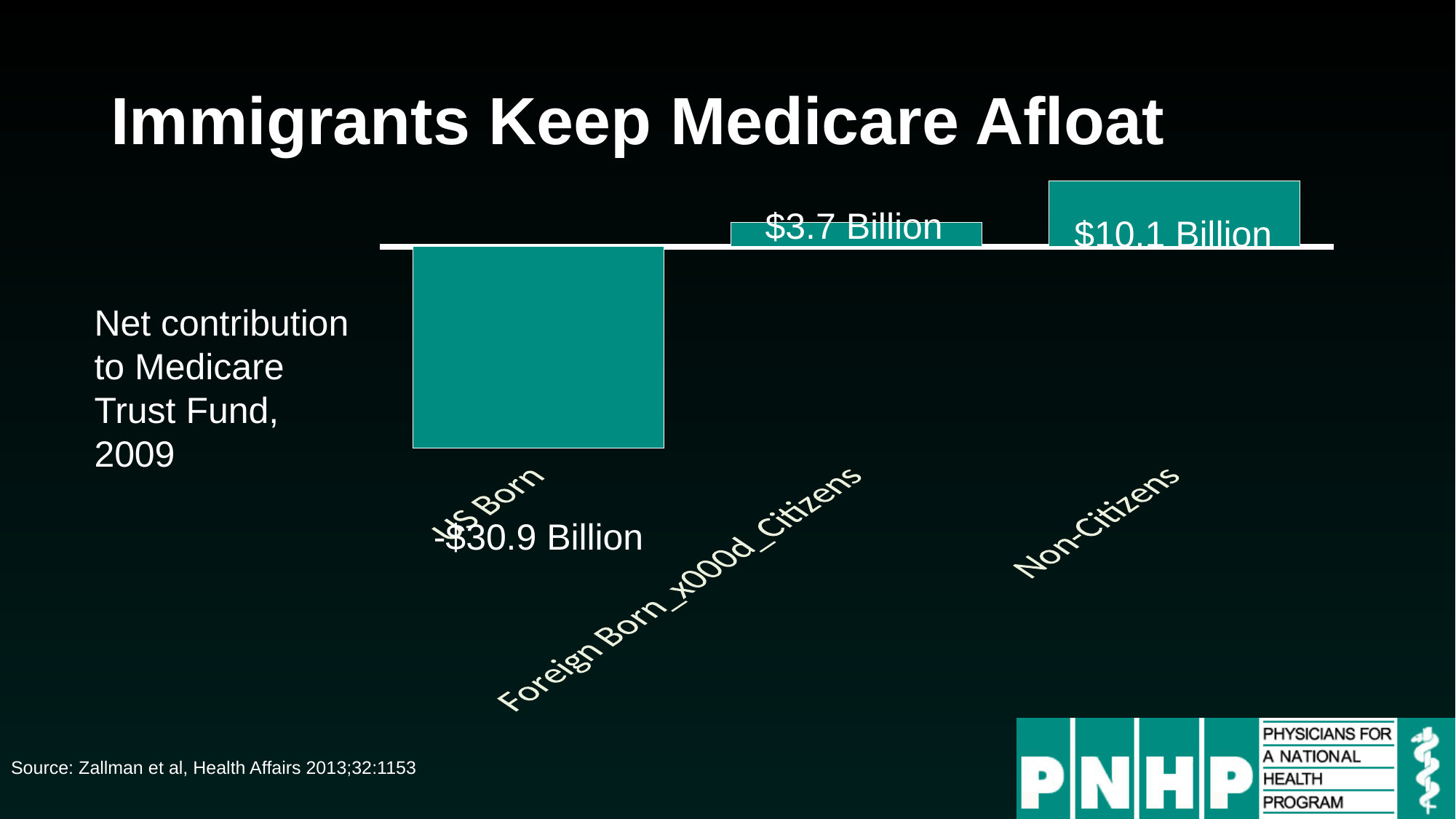
Which category has the highest net contribution to the Medicare Trust Fund? Non-Citizens What is the net contribution to the Medicare Trust Fund for US Born? -$30.9 Billion What is the net contribution to the Medicare Trust Fund for Foreign Born Citizens? $3.7 Billion What is the title of the slide? Immigrants Keep Medicare Afloat What measure and year does the chart show? Net contribution to Medicare Trust Fund, 2009 How much larger is the net contribution of Non-Citizens than that of Foreign Born Citizens? $6.4 Billion How many categories are shown in the chart? 3 Which category has the lowest net contribution to the Medicare Trust Fund? US Born What kind of chart is shown on the slide? Bar chart Which contributes more to the Medicare Trust Fund, Foreign Born Citizens or Non-Citizens? Non-Citizens What is the difference between the net contribution of Non-Citizens and US Born? $41.0 Billion What is the net contribution to the Medicare Trust Fund for Non-Citizens? $10.1 Billion